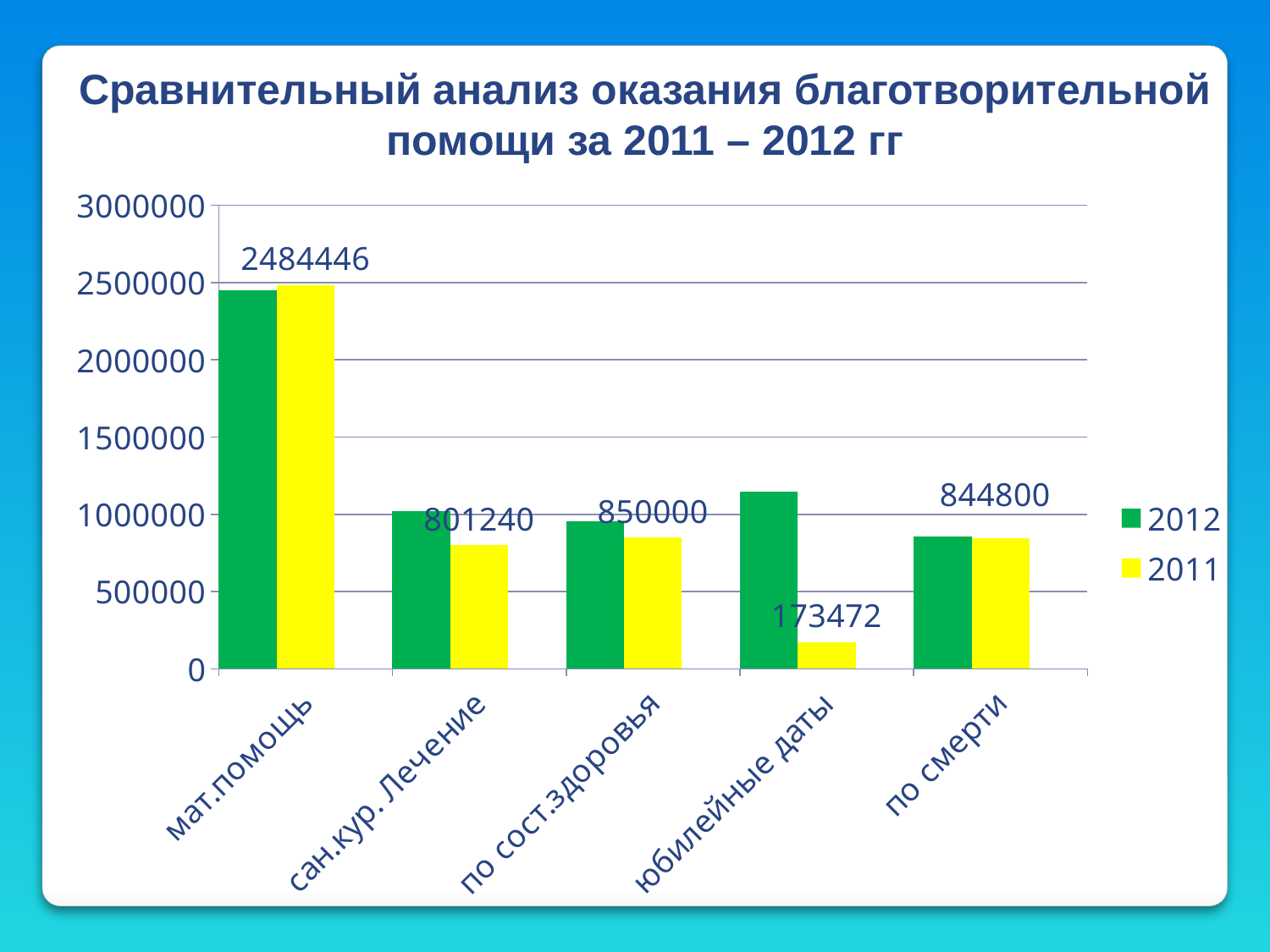
What is the difference between the 2011 values for по сост.здоровья and сан.кур. Лечение? 48760 For юбилейные даты, which series has the larger value, 2012 or 2011? 2012 What kind of chart is shown on the slide? bar chart How many categories are shown on the x axis? 5 What is the 2011 value for по смерти? 844800 What is the 2011 value for юбилейные даты? 173472 Is the 2012 value for юбилейные даты greater or less than 1000000? greater What is the 2011 value for мат.помощь? 2484446 How many series does the legend list? 2 Which category has the highest 2011 value? мат.помощь Which category has the lowest 2011 value? юбилейные даты Is the 2012 value for мат.помощь greater or less than 2000000? greater